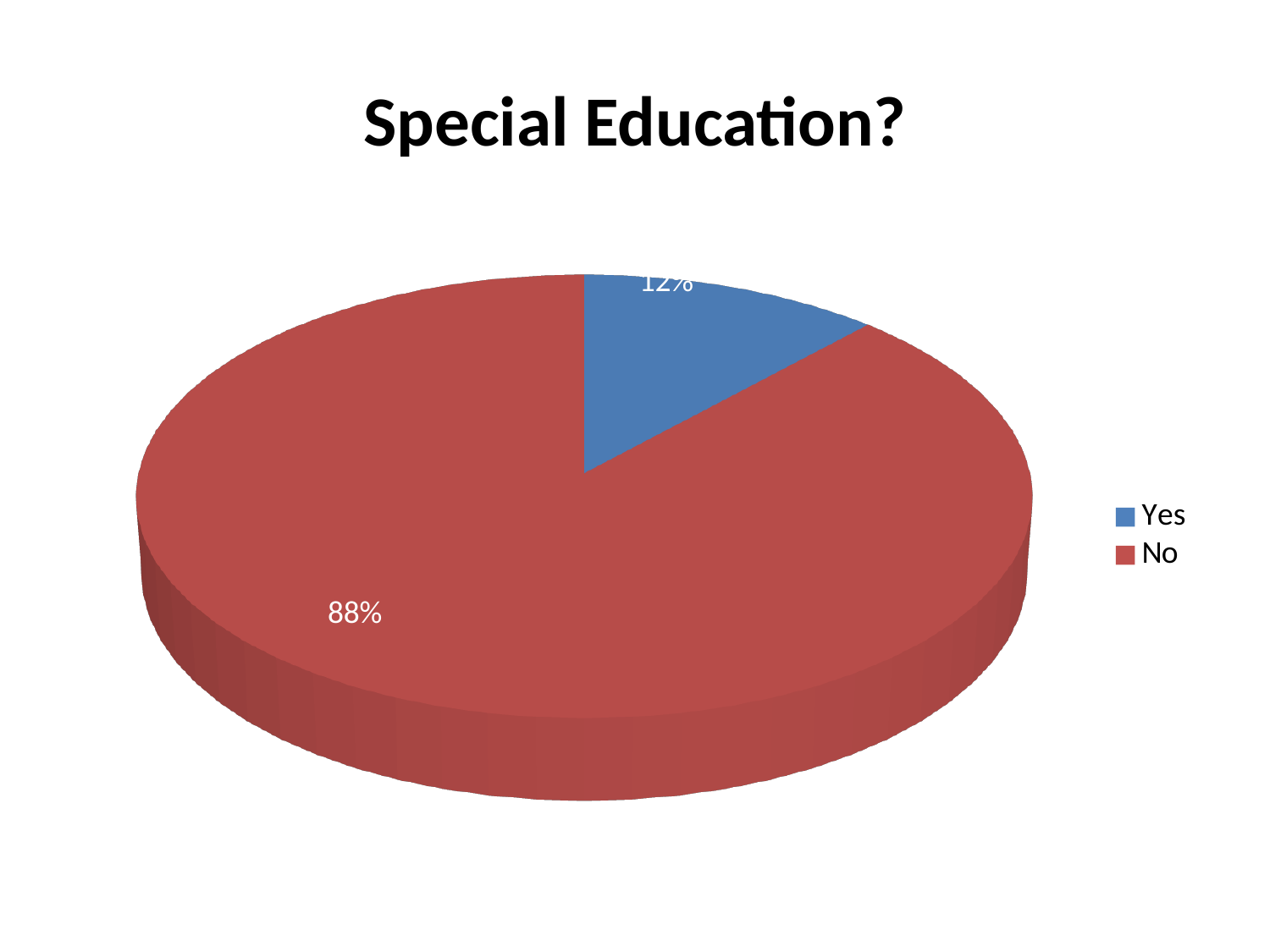
Which slice is larger, "Yes" or "No"? No What share of the pie does the "No" slice represent? 88% What colour is the "Yes" slice? blue What is the difference in percentage points between the "No" and "Yes" slices? 76 Which category has the largest slice of the pie? No What kind of chart is shown on the slide? pie chart Which category has the smallest slice of the pie? Yes How many categories does the legend list? 2 What is the title of the chart? Special Education? What share of the pie does the "Yes" slice represent? 12%